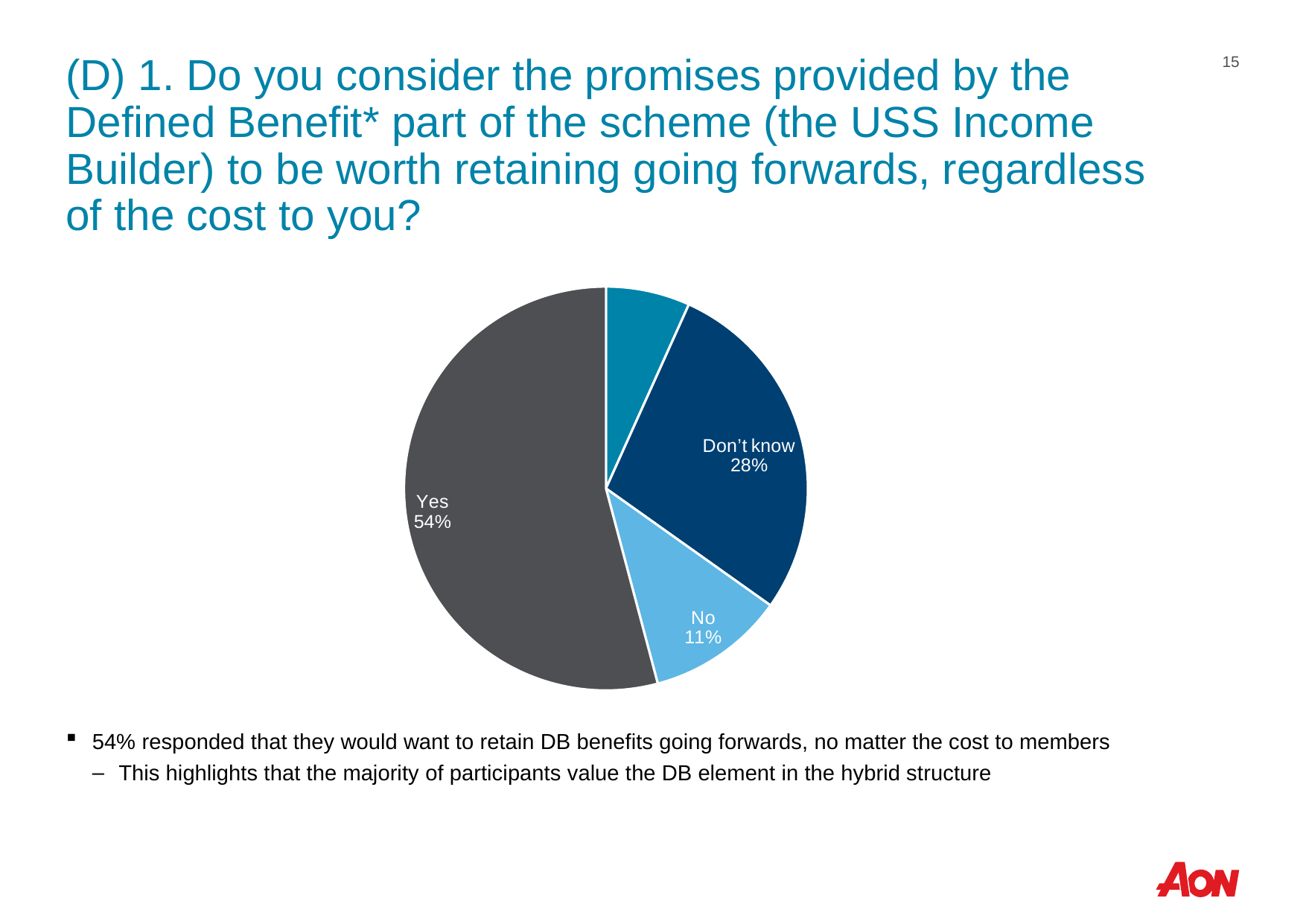
What is the difference in percentage points between the "Yes" and "Don't know" slices? 26 How many slices of the pie chart have a text label? 3 What is the difference in percentage points between the "Don't know" and "No" slices? 17 What percentage of respondents answered "Don't know"? 28% Which labelled response has the smallest share of the pie? No What percentage of respondents answered "No"? 11% Which is larger, the "Don't know" slice or the "No" slice? Don't know Which labelled response has the largest share of the pie? Yes What percentage of respondents answered "Yes"? 54% What kind of chart is shown on the slide? Pie chart What colour is the "Yes" slice of the pie chart? Dark grey How many slices does the pie chart have? 4